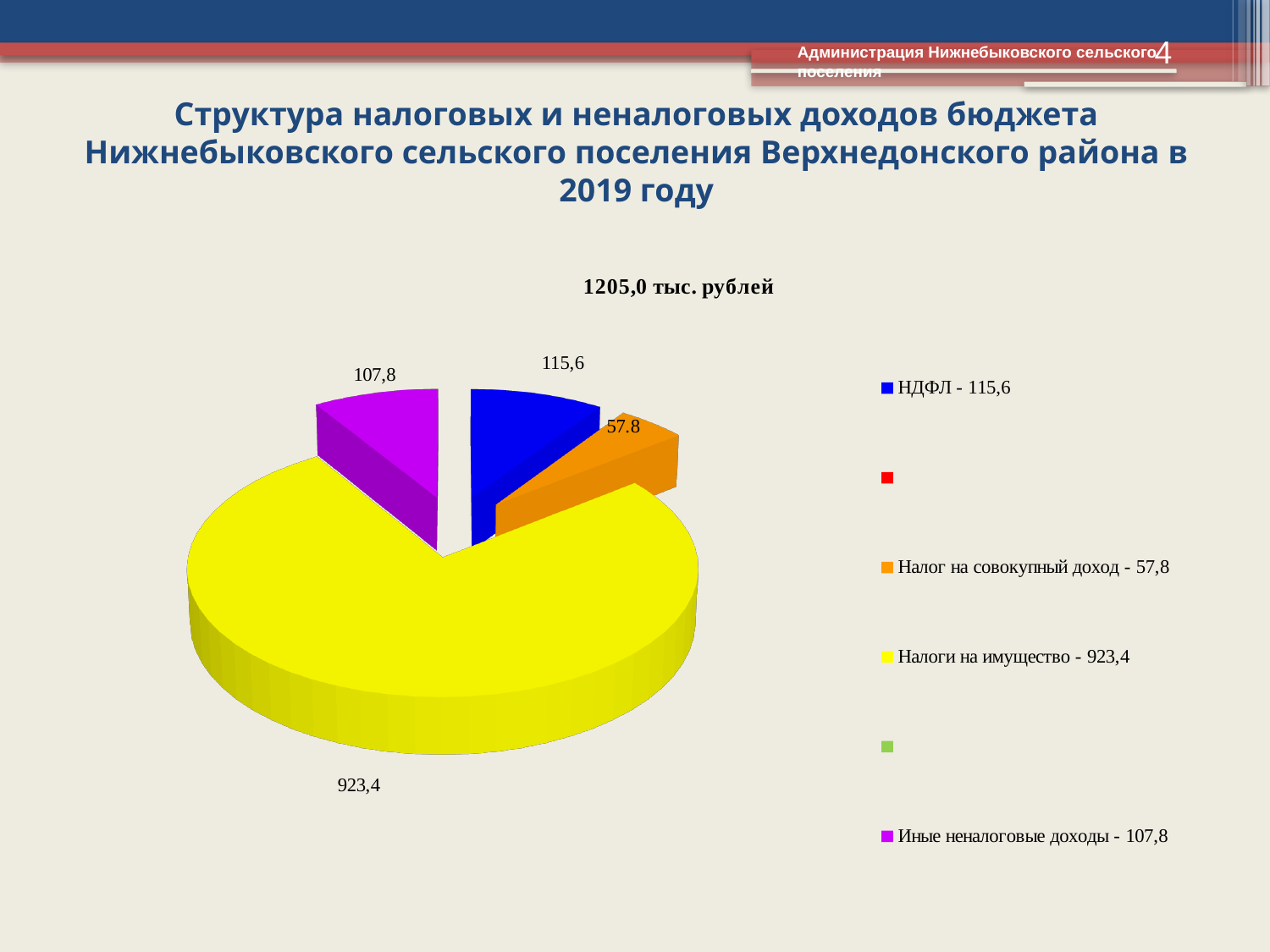
What is the value for НДФЛ? 115,6 What is the difference between the values for Налоги на имущество and Иные неналоговые доходы? 815,6 What is the value for Налоги на имущество? 923,4 Which category has the smallest slice of the pie? Налог на совокупный доход What type of chart is shown on the slide? pie chart What is the value for Налог на совокупный доход? 57,8 What is the difference between the values for НДФЛ and Налог на совокупный доход? 57,8 Which is larger, the value for НДФЛ or the value for Иные неналоговые доходы? НДФЛ Which category has the largest slice of the pie? Налоги на имущество What total amount is shown in the chart title above the pie? 1205,0 тыс. рублей What is the value for Иные неналоговые доходы? 107,8 How many slices does the pie chart have? 4